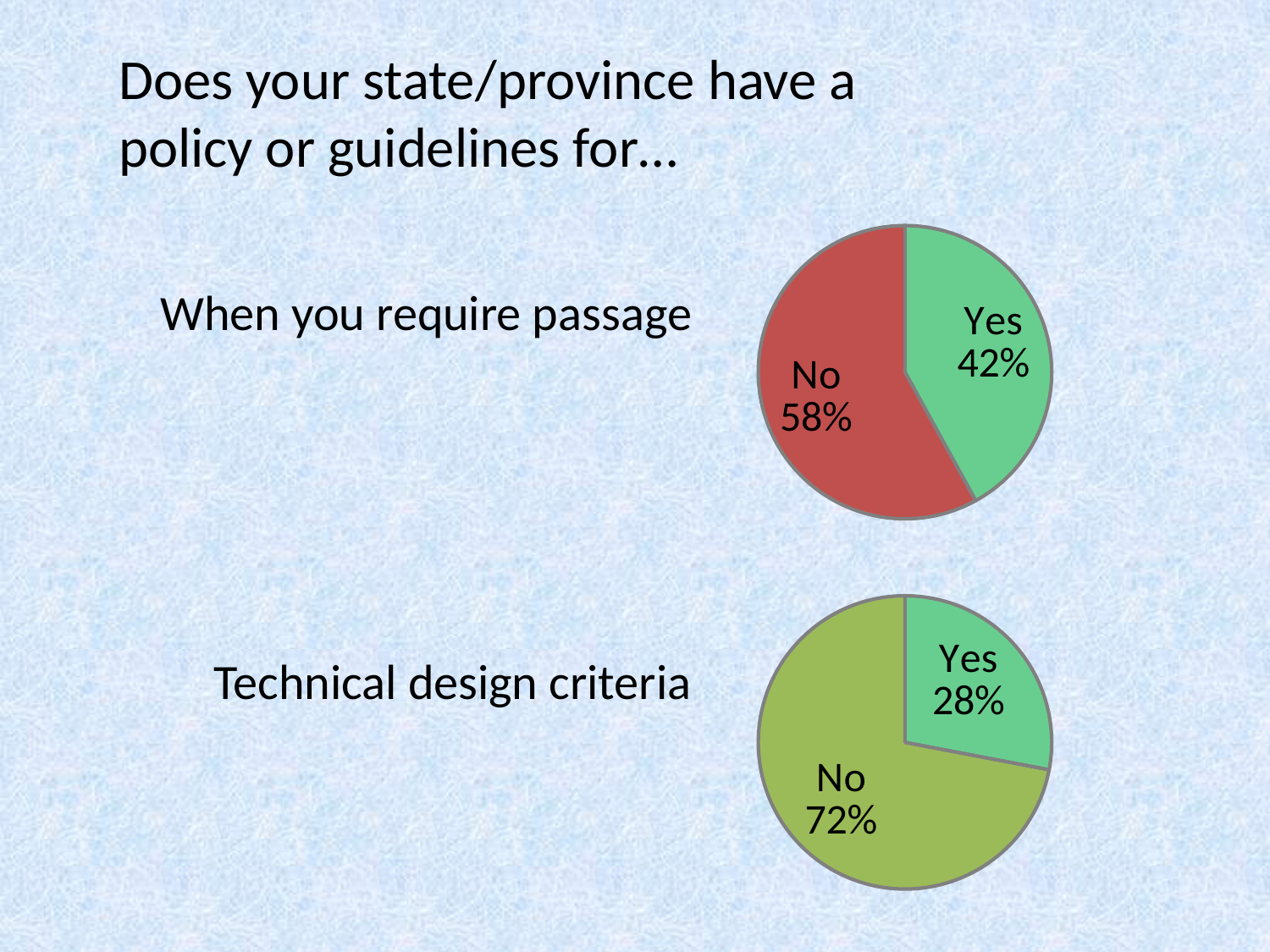
What type of chart is used for the Technical design criteria data? Pie chart In the bottom pie chart (Technical design criteria), what share of respondents answered No? 72% In the top pie chart (When you require passage), which response has the larger share? No In the bottom pie chart (Technical design criteria), what share of respondents answered Yes? 28% In the bottom pie chart (Technical design criteria), which response has the smaller share? Yes In the bottom pie chart (Technical design criteria), what colour is the No slice? Green (olive green) Which chart has the larger Yes share, the top chart (When you require passage) or the bottom chart (Technical design criteria)? When you require passage In the top pie chart (When you require passage), what is the difference between the No and Yes shares? 16% In the top pie chart (When you require passage), what share of respondents answered No? 58% How many slices does the top pie chart (When you require passage) have? 2 In the top pie chart (When you require passage), what share of respondents answered Yes? 42% In the bottom pie chart (Technical design criteria), what is the difference between the No and Yes shares? 44%